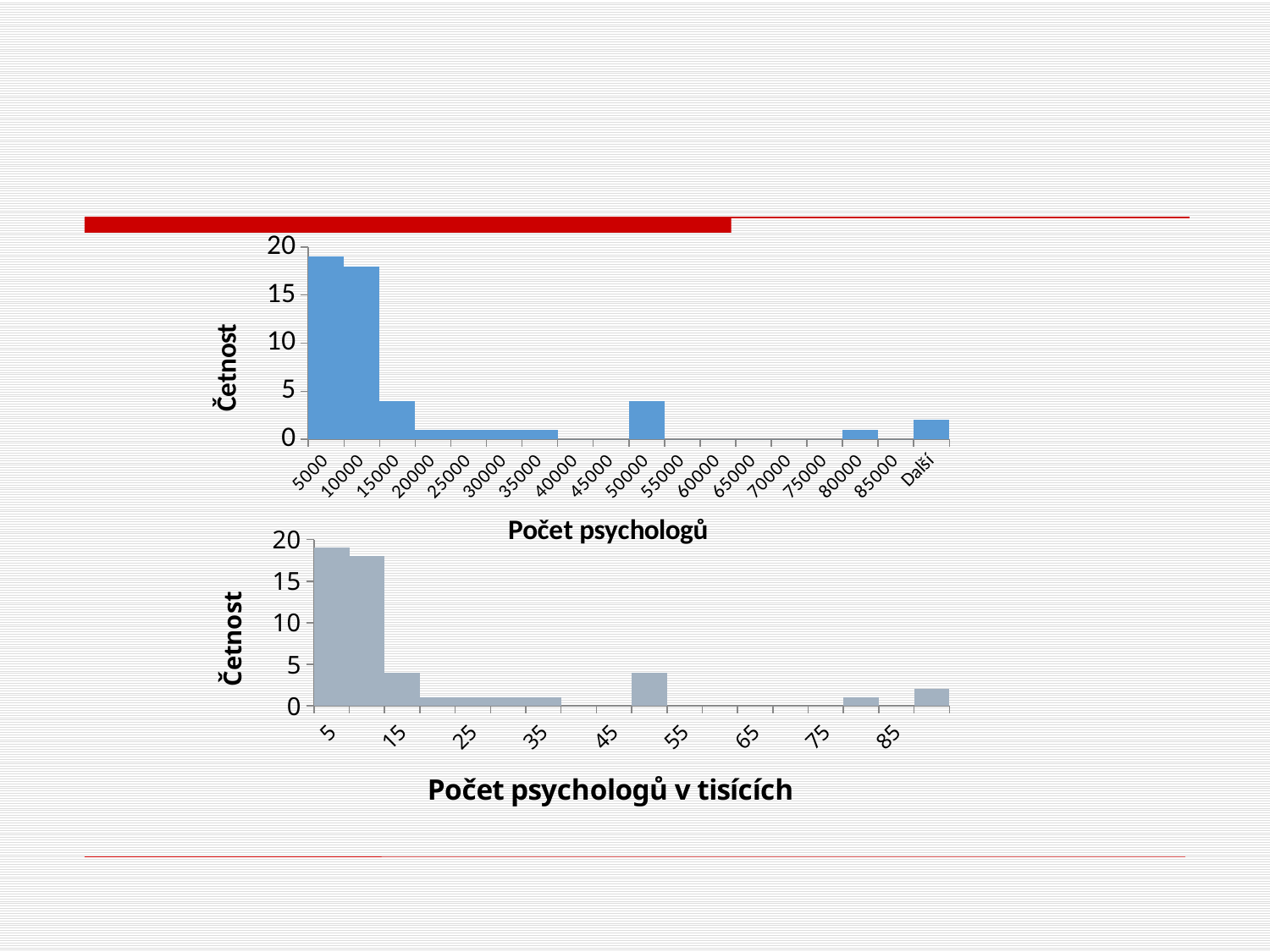
In the top chart (Počet psychologů), is the value for 50000 greater or less than 5? less In the bottom chart (Počet psychologů v tisících), which is larger, the value for 45 or the value for 55? Neither; both are 0 In the bottom chart (Počet psychologů v tisících), is the value for 5 greater or less than 15? greater In the top chart (Počet psychologů), which is larger, the value for 50000 or the value for 80000? 50000 In the top chart (Počet psychologů), which is larger, the value for 15000 or the value for 20000? 15000 In the top chart (Počet psychologů), how many categories are shown on the x axis? 18 What is the y-axis title of the bottom chart? Četnost What kind of chart is the top chart on the slide? bar chart In the top chart (Počet psychologů), which category has the highest frequency? 5000 In the top chart (Počet psychologů), is the value for 5000 greater or less than 15? greater In the top chart (Počet psychologů), do the values generally rise or fall from 5000 to 35000? fall